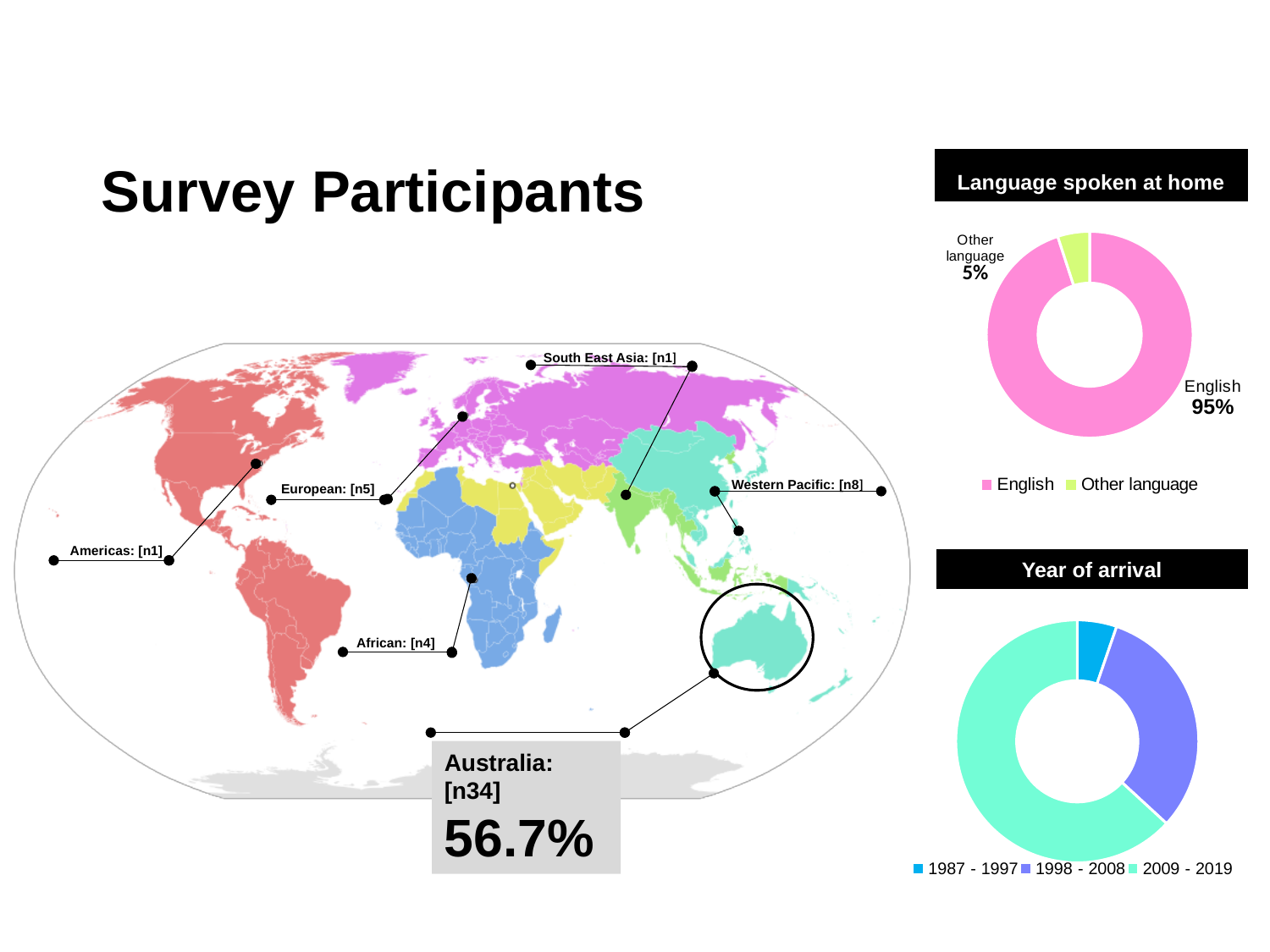
What kind of chart is the 'Year of arrival' chart? Doughnut (pie) chart How many categories does the 'Year of arrival' chart show? 3 In the 'Language spoken at home' chart, what percentage is shown for English? 95% In the 'Year of arrival' chart, which period has the largest slice? 2009 - 2019 In the 'Language spoken at home' chart, what percentage is shown for Other language? 5% What kind of chart is the 'Language spoken at home' chart? Doughnut (pie) chart In the 'Year of arrival' chart, which period has the smallest slice? 1987 - 1997 In the 'Year of arrival' chart, which slice is larger: 1998 - 2008 or 1987 - 1997? 1998 - 2008 How many entries does the legend of the 'Language spoken at home' chart list? 2 In the 'Language spoken at home' chart, which category has the largest share? English In the 'Language spoken at home' chart, what is the difference between the English and Other language percentages? 90% What is the title of the chart at the top right of the slide? Language spoken at home